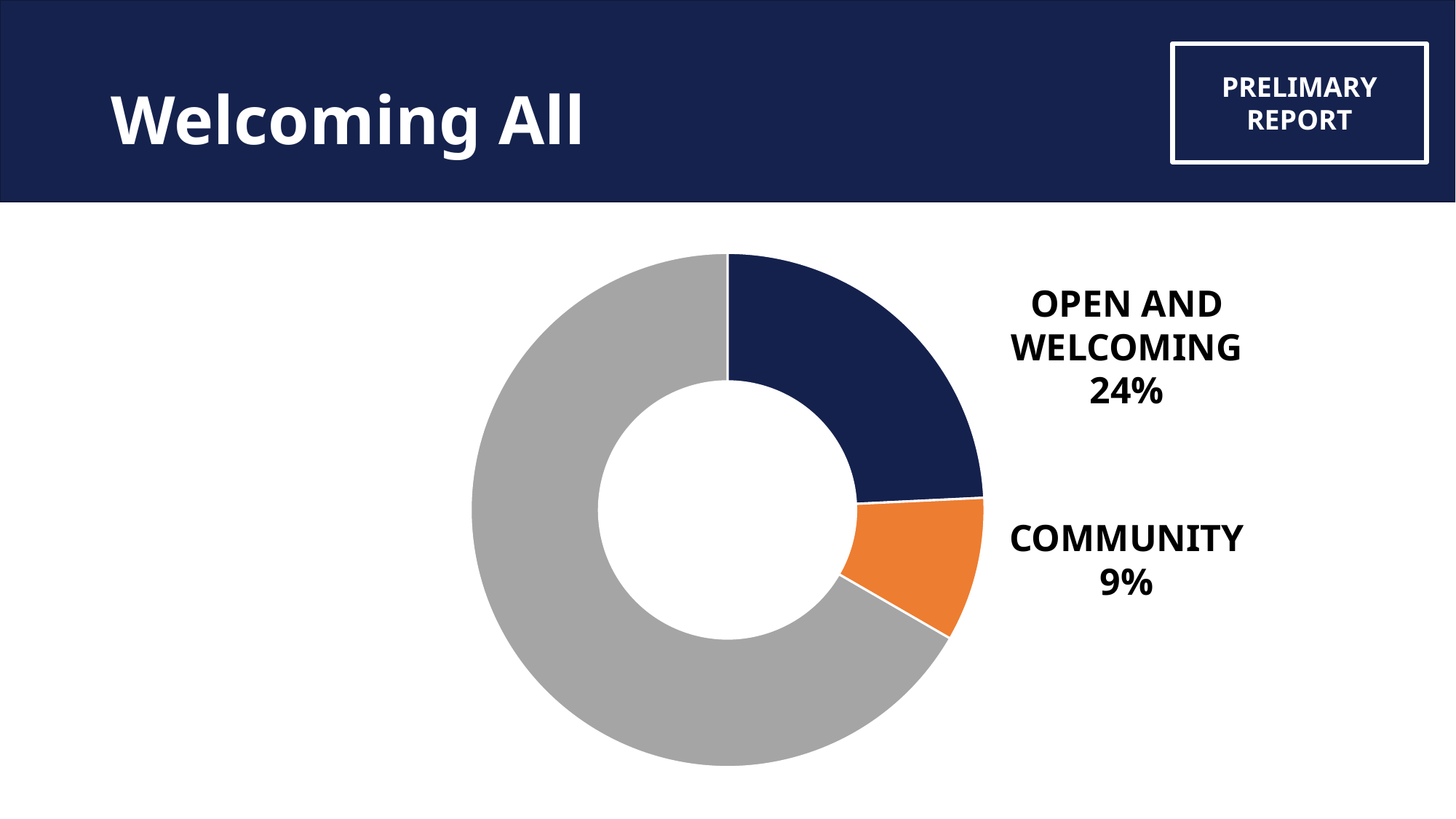
How many slices does the chart have? 3 What percentage is shown for the Community slice? 9% Which slice of the chart is the smallest? Community What percentage is shown for the Open and Welcoming slice? 24% What share of the chart does the Community slice represent? 9% What colour is the Community slice? orange Which is larger, the Open and Welcoming slice or the Community slice? Open and Welcoming What kind of chart is shown on the slide? doughnut chart What colour is the Open and Welcoming slice? dark blue What is the difference in percentage points between the Open and Welcoming slice and the Community slice? 15%